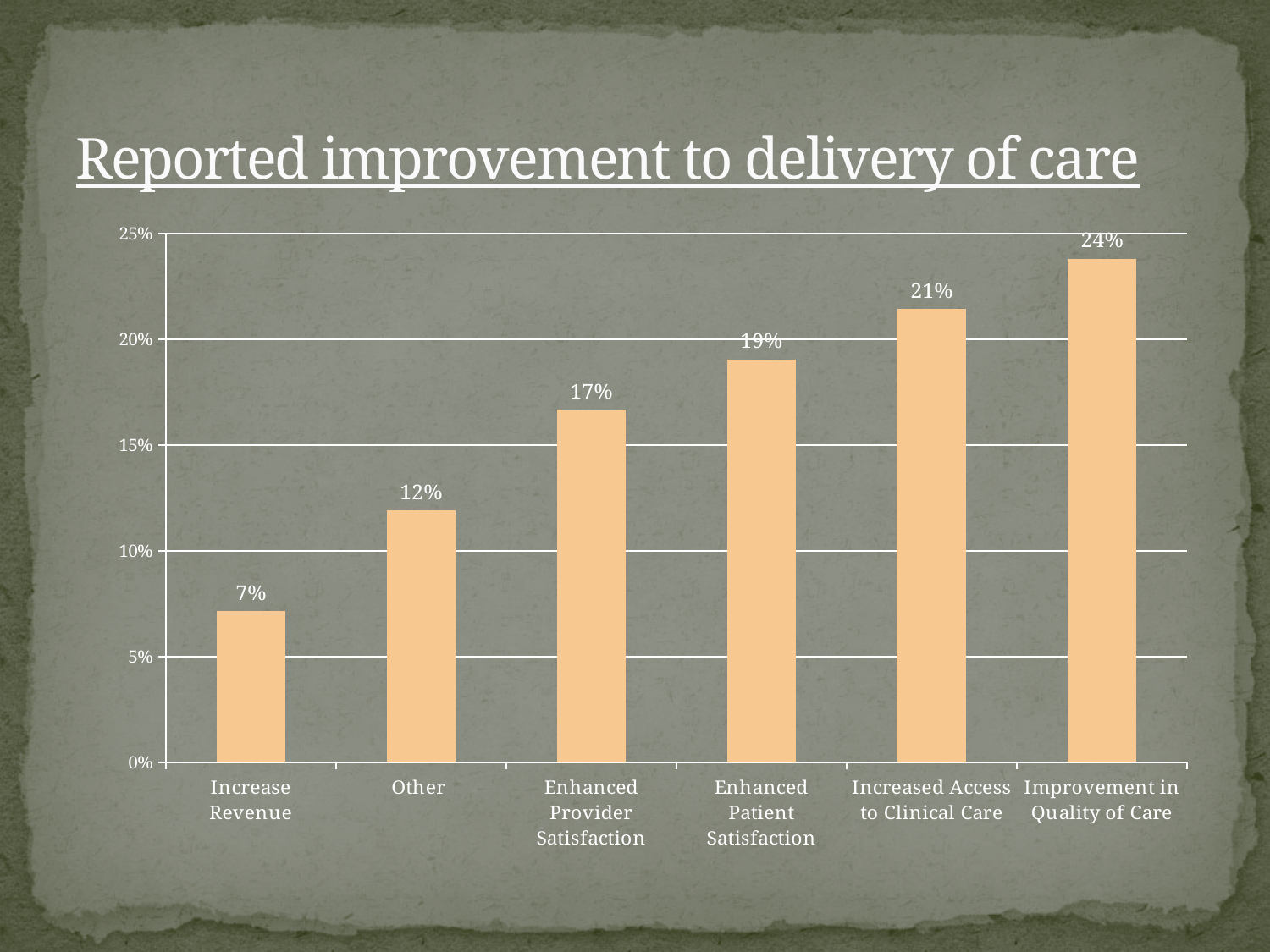
What is the title of the chart? Reported improvement to delivery of care Which category has the lowest value? Increase Revenue How many categories are shown on the chart? 6 Is the value for Other greater or less than 10%? greater What is the value for Enhanced Provider Satisfaction? 17% What is the difference between Enhanced Patient Satisfaction and Other? 7% Which is larger, Enhanced Patient Satisfaction or Enhanced Provider Satisfaction? Enhanced Patient Satisfaction What kind of chart is shown on the slide? Bar chart What is the difference between Improvement in Quality of Care and Increase Revenue? 17% What is the value for Increase Revenue? 7% Which category has the highest value? Improvement in Quality of Care What is the value for Increased Access to Clinical Care? 21%